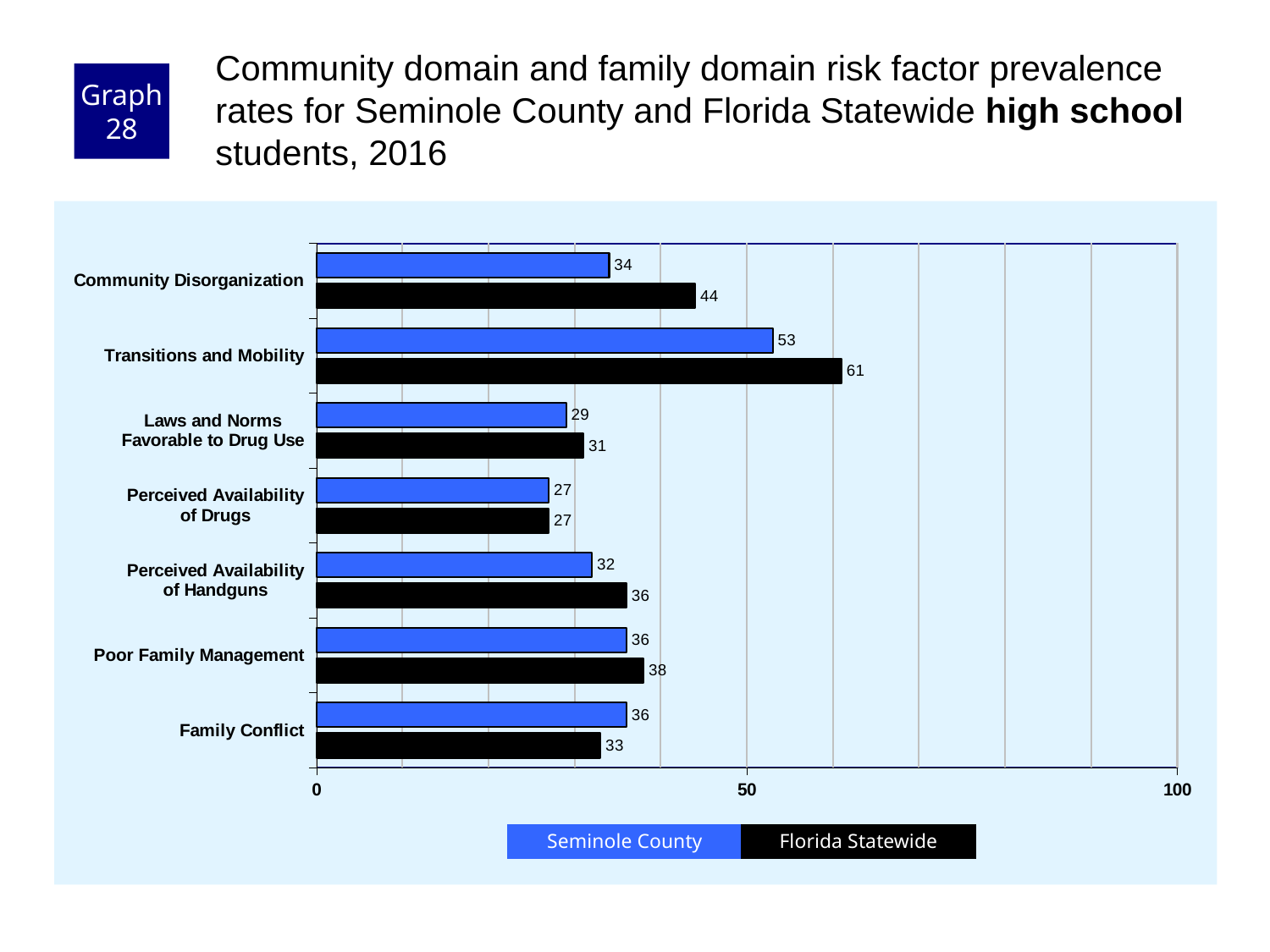
What is the Florida Statewide value for Family Conflict? 33 What is the Seminole County value for Transitions and Mobility? 53 Is the Florida Statewide value for Transitions and Mobility greater or less than 50? greater What kind of chart is shown on the slide? Bar chart What is the difference between the Florida Statewide and Seminole County values for Community Disorganization? 10 Which risk factor has the highest Florida Statewide value? Transitions and Mobility What is the difference between the Florida Statewide and Seminole County values for Transitions and Mobility? 8 How many series does the legend list? 2 What is the Florida Statewide value for Community Disorganization? 44 Which risk factor has the lowest Seminole County value? Perceived Availability of Drugs For Family Conflict, which is larger: the Seminole County value or the Florida Statewide value? Seminole County How many risk factors are shown on the chart? 7